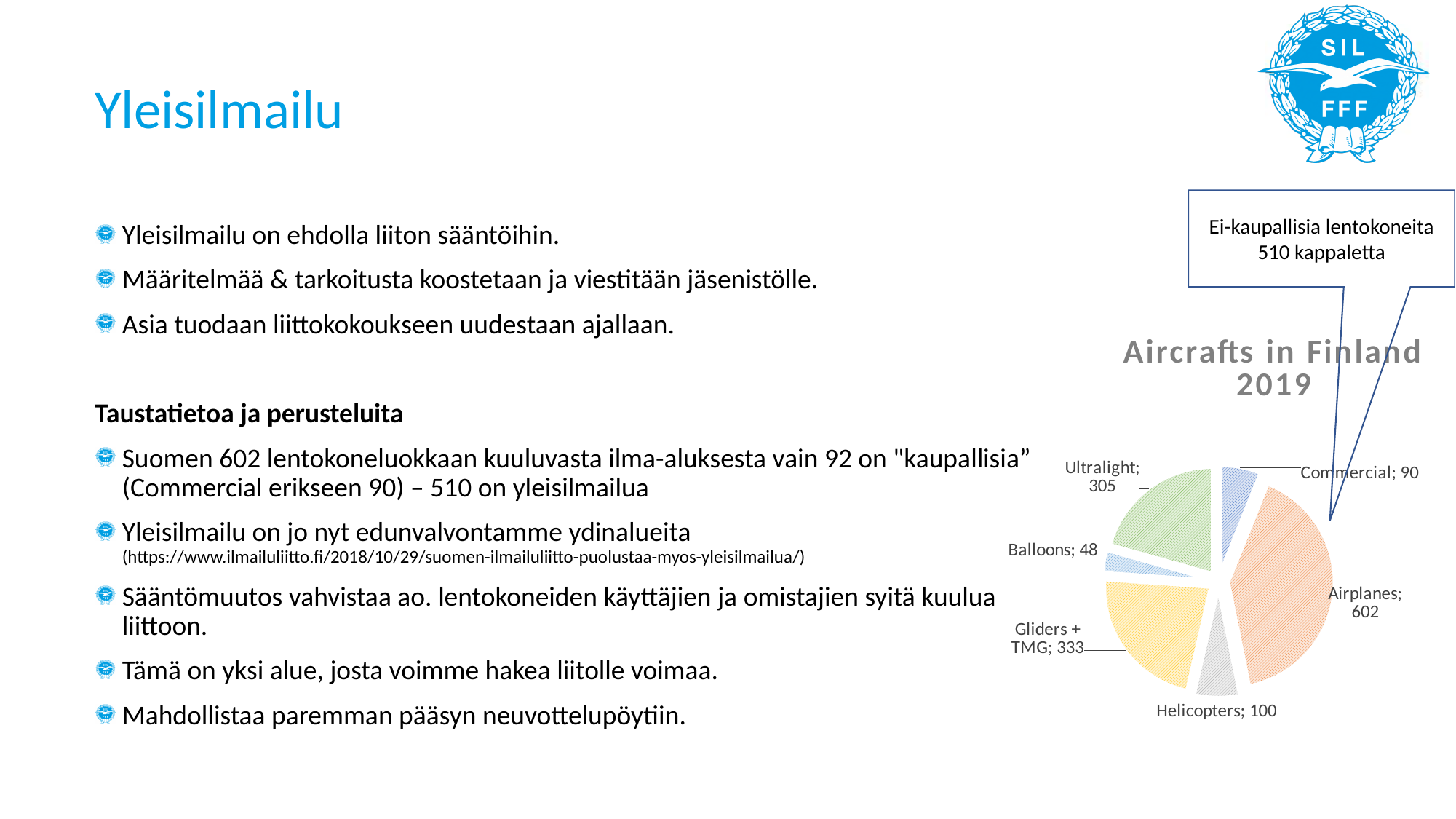
What is the value for Balloons in the pie chart? 48 Which category has the largest slice in the pie chart? Airplanes What is the difference between the Airplanes value and the Ultralight value? 297 What is the difference between the Helicopters value and the Commercial value? 10 What is the value for Gliders + TMG in the pie chart? 333 What is the value for Airplanes in the pie chart? 602 What is the value for Helicopters in the pie chart? 100 What type of chart is shown on the slide? pie chart Which category has the smallest slice in the pie chart? Balloons How many slices does the pie chart have? 6 What is the title of the chart? Aircrafts in Finland 2019 Which is larger, Gliders + TMG or Ultralight? Gliders + TMG